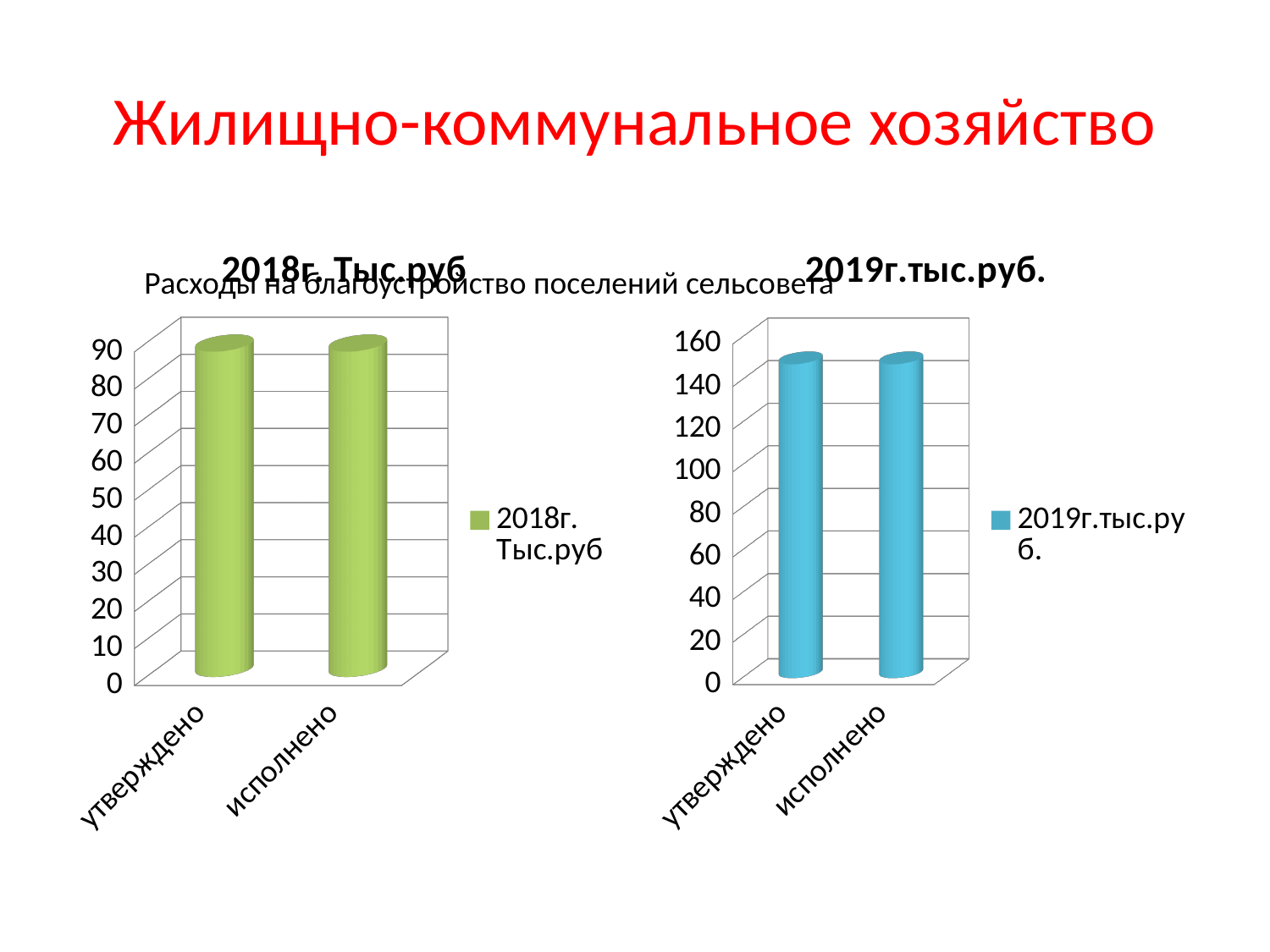
What kind of chart is the left chart titled "2018г. Тыс.руб"? bar chart What colour are the bars in the left chart (2018г. Тыс.руб)? green In the right chart (2019г.тыс.руб.), is the value for утверждено greater or less than 140? greater What is the legend entry of the right chart (2019г.тыс.руб.)? 2019г.тыс.руб. How many series does the legend of the left chart (2018г. Тыс.руб) list? 1 How many categories are shown on the x axis of the left chart (2018г. Тыс.руб)? 2 In the right chart (2019г.тыс.руб.), is the value for исполнено greater or less than 160? less In the left chart (2018г. Тыс.руб), is the value for утверждено greater or less than 80? greater What kind of chart is the right chart titled "2019г.тыс.руб."? bar chart How many categories are shown on the x axis of the right chart (2019г.тыс.руб.)? 2 How many series does the legend of the right chart (2019г.тыс.руб.) list? 1